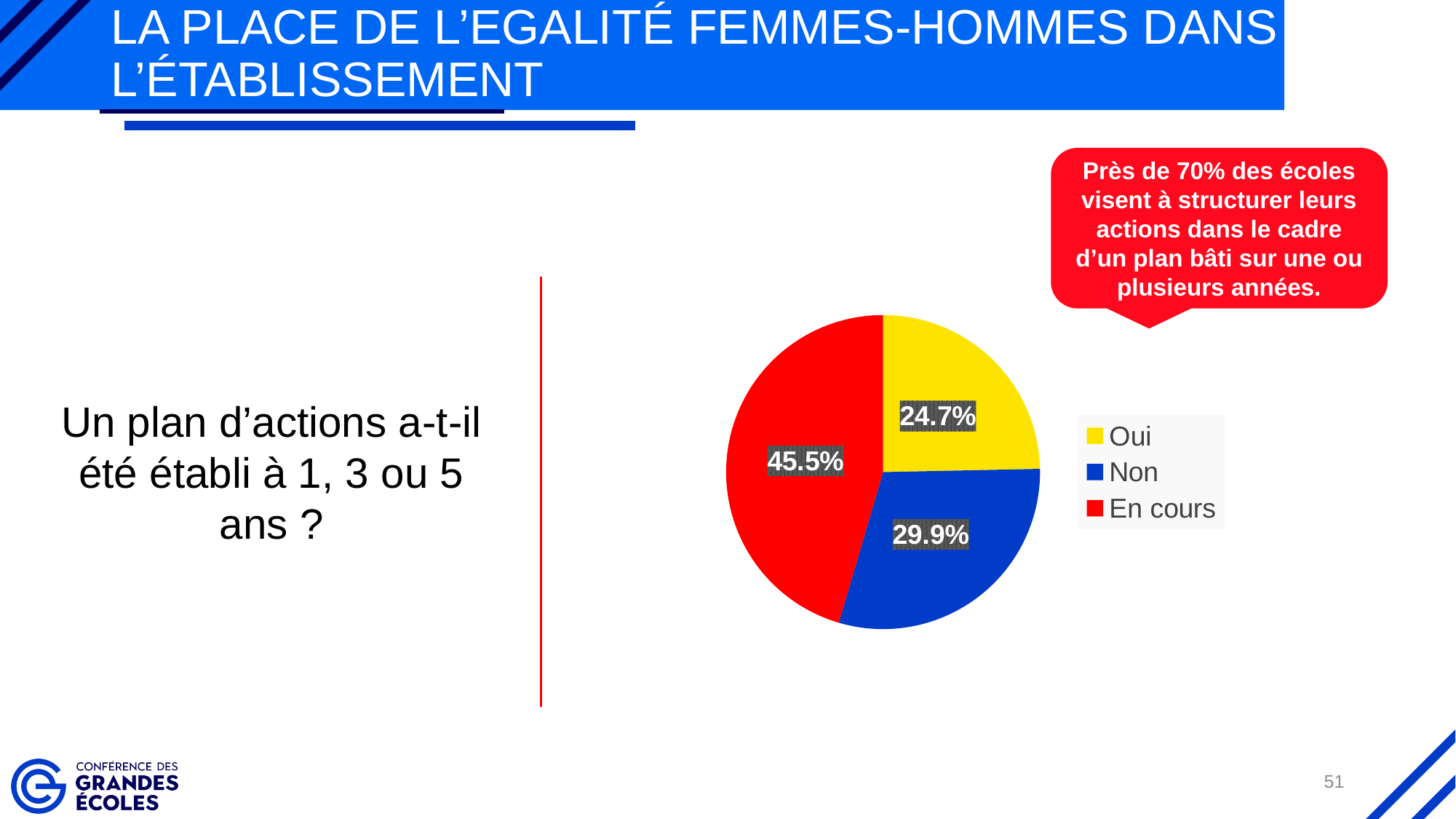
What is the difference in percentage points between the "En cours" slice and the "Non" slice? 15.6 Which category has the largest slice of the pie? En cours What colour is the "En cours" slice in the pie chart? red Which category has the smallest slice of the pie? Oui Which category is shown in yellow in the legend? Oui What kind of chart is shown on the slide? pie chart What percentage of the pie is labelled "En cours"? 45.5% What percentage of the pie is labelled "Non"? 29.9% What percentage of the pie is labelled "Oui"? 24.7% Which slice is larger, "Oui" or "Non"? Non What is the difference in percentage points between the "Non" slice and the "Oui" slice? 5.2 How many slices does the pie chart have? 3